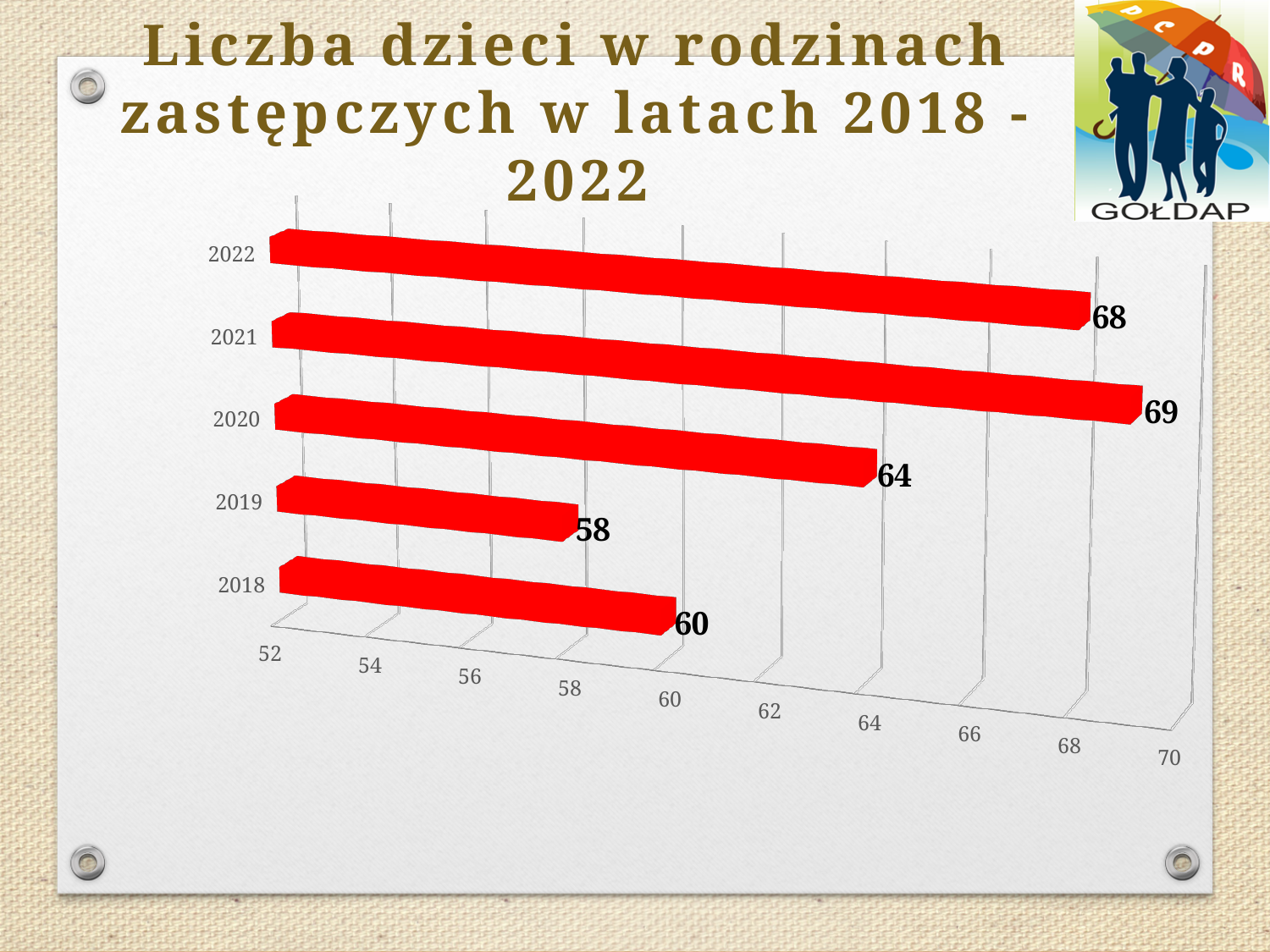
Is the value for 2021 greater or less than 66? greater What kind of chart is shown on the slide? bar chart Which is larger, the value for 2020 or the value for 2022? 2022 Which year has the highest value? 2021 What is the difference between the values for 2020 and 2018? 4 What is the number of children in foster families in 2022? 68 Which year has the lowest value? 2019 How many years are shown on the chart? 5 What is the value shown for 2018? 60 What is the value shown for 2019? 58 What is the difference between the values for 2021 and 2019? 11 What is the title of the chart? Liczba dzieci w rodzinach zastępczych w latach 2018 - 2022